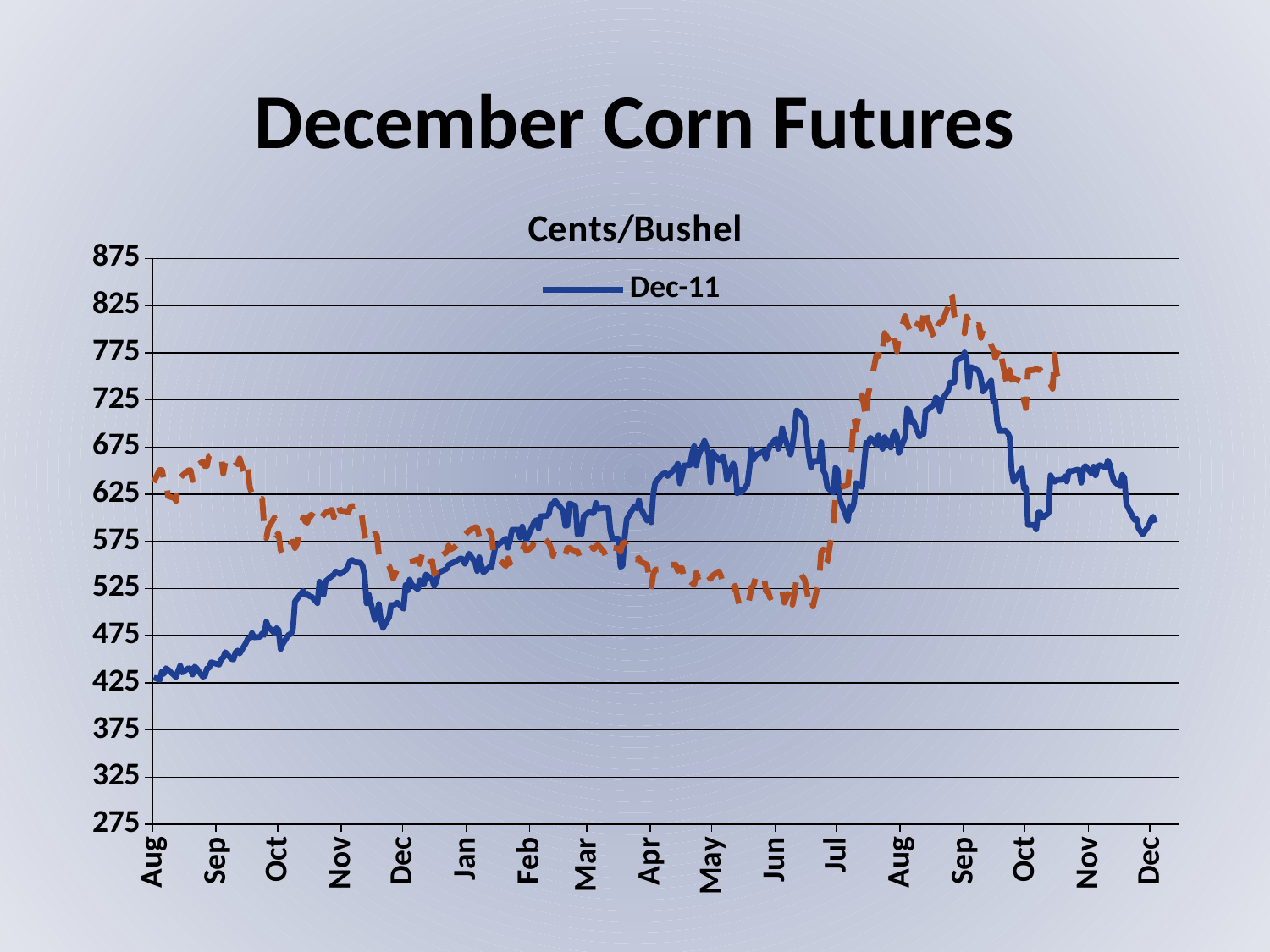
Which is larger for Dec-11: the value at the start of the chart (first Aug) or the value at the end (second Dec)? the end (second Dec) How many series does the legend list? 1 How many month labels are shown along the x axis? 17 What kind of chart is shown on the slide? line chart Is the Dec-11 value around Jun greater or less than 625? greater What colour is the Dec-11 line in the legend? blue Is the Dec-11 value at the end of the chart (second Dec) greater or less than 625? less What is the title shown above the chart's plot area? Cents/Bushel Does the Dec-11 line generally rise or fall from the first Aug to Feb? rise Is the Dec-11 value at the start of the chart (first Aug) greater or less than 475? less